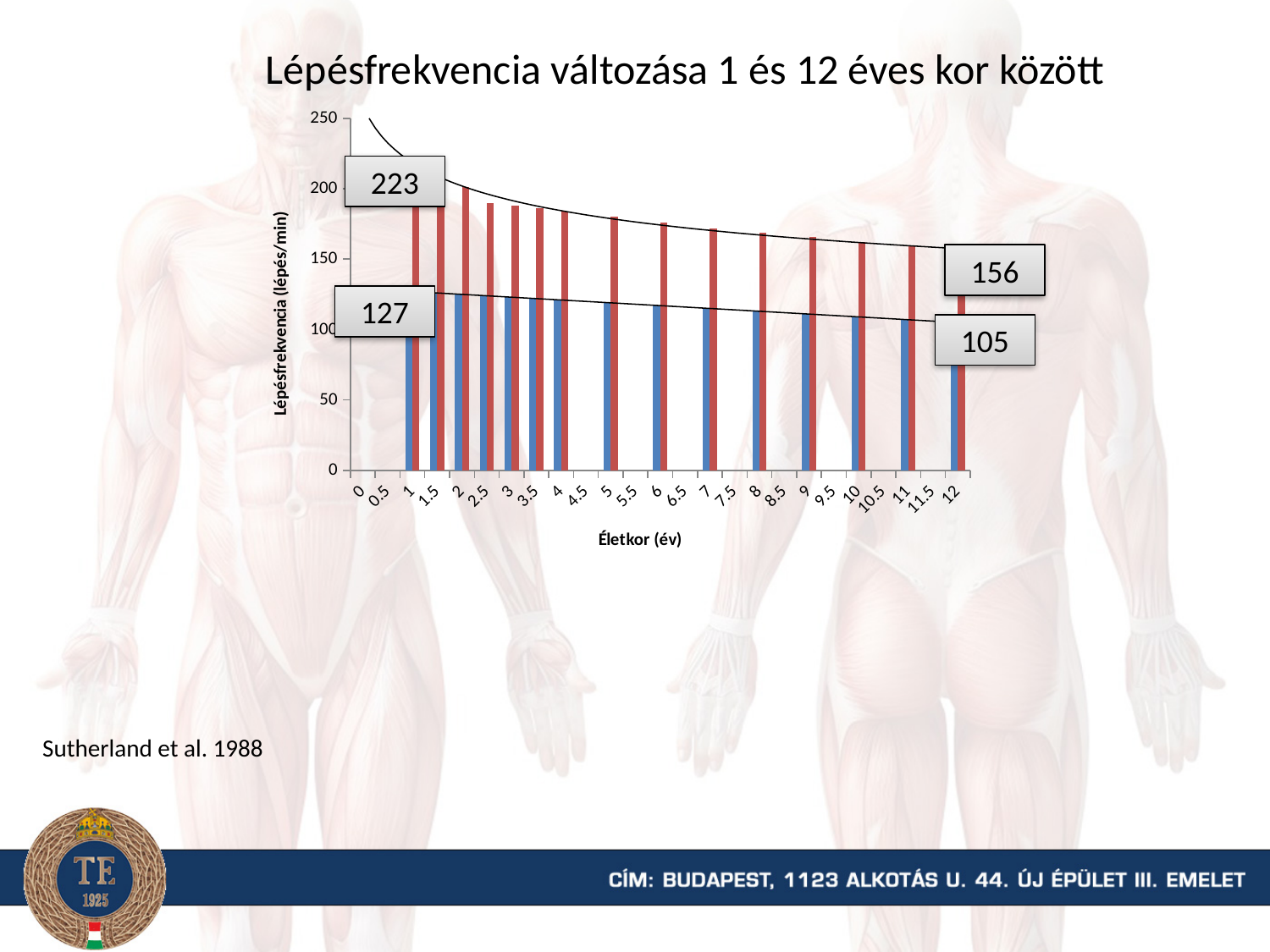
Is the value of the red bar at age 6 greater or less than 150? greater What kind of chart is shown on the slide? bar chart At age 1, which bar is taller, the red one or the blue one? the red one What is the labelled value of the blue bar at age 1? 127 Do the step frequency values rise or fall as age increases along the x axis? fall What is the labelled value of the red bar at age 12? 156 Is the value of the blue bar at age 2 greater or less than 150? less What is the difference between the blue series values at age 1 (127) and age 12 (105)? 22 What is the labelled value of the blue bar at age 12? 105 By how much does the red series decrease from age 1 (223) to age 12 (156)? 67 What is the title of the vertical axis? Lépésfrekvencia (lépés/min) What is the labelled value of the red bar at age 1? 223